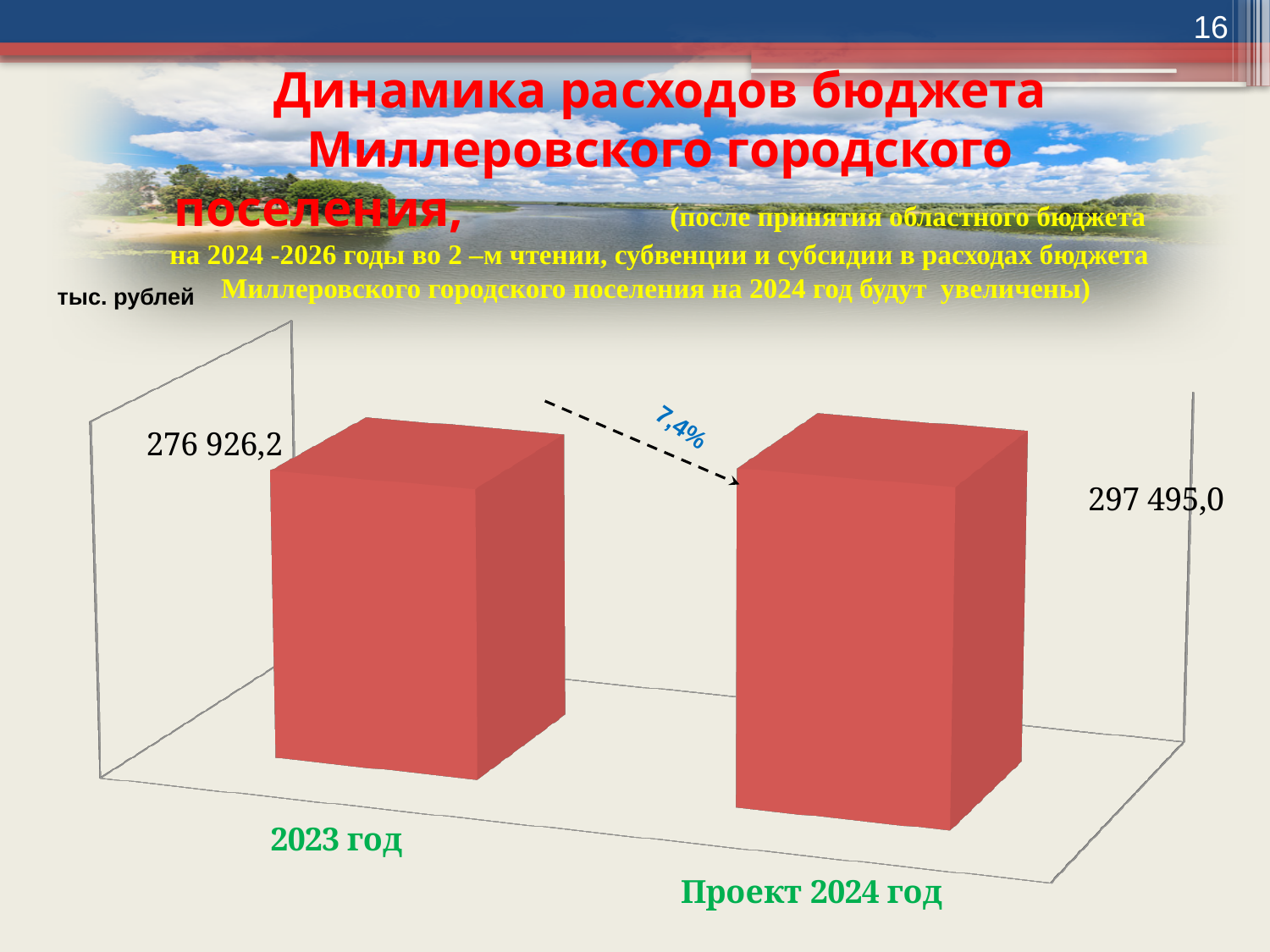
What is the budget expenditure value shown for 2023 год? 276 926,2 Which category has the highest value on the chart? Проект 2024 год How many bars are plotted on the chart? 2 Which category has the higher value, 2023 год or Проект 2024 год? Проект 2024 год What percentage change is shown by the arrow between the two bars? 7,4% Do the values rise or fall from 2023 год to Проект 2024 год? rise What is the budget expenditure value shown for Проект 2024 год? 297 495,0 Which category has the lowest value on the chart? 2023 год What is the difference between the values for Проект 2024 год and 2023 год? 20 568,8 What kind of chart is shown on the slide? bar chart In what units are the chart values expressed, according to the label at the top left of the chart? тыс. рублей